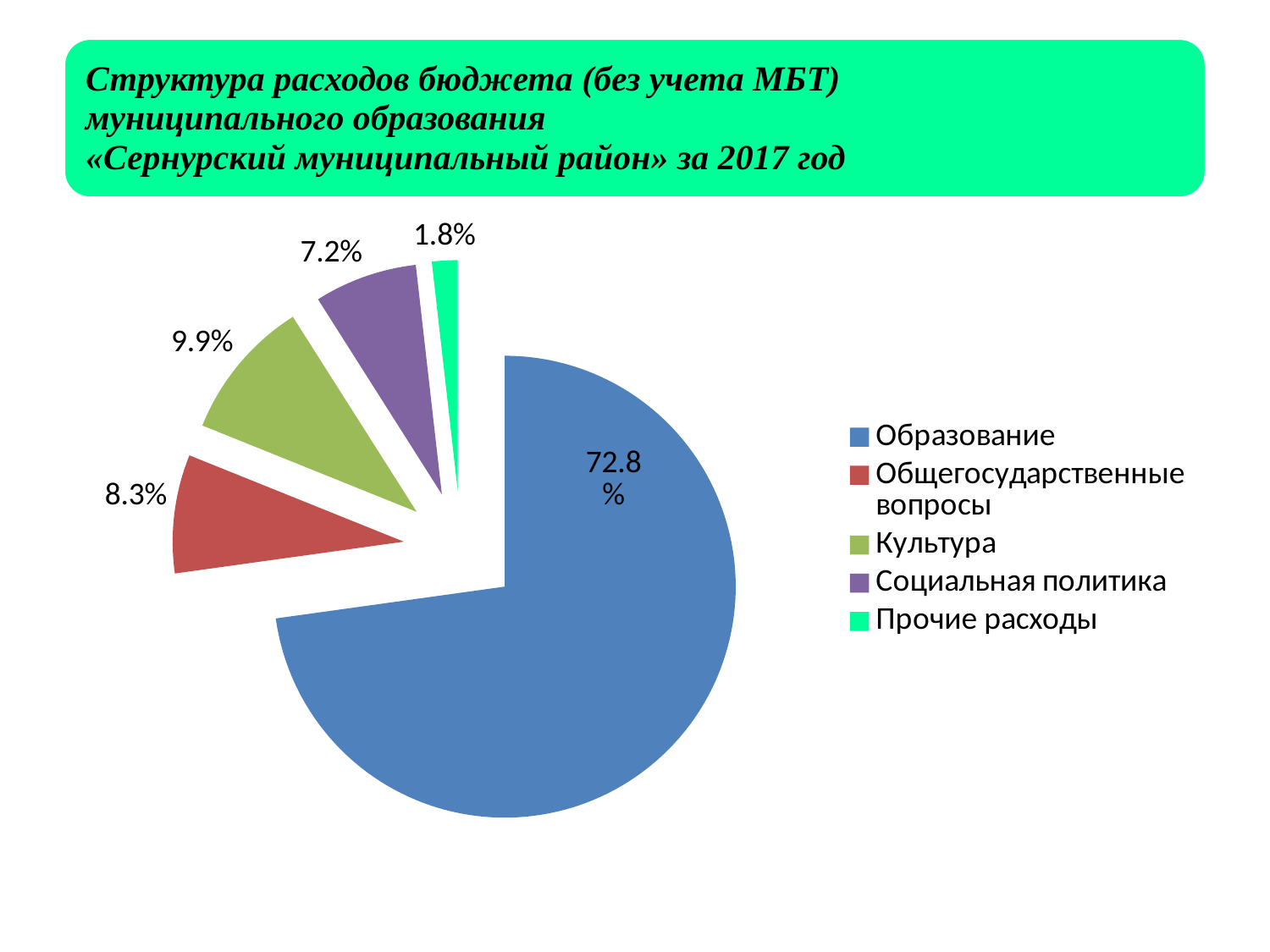
Which category is shown in blue in the legend? Образование What kind of chart is shown on the slide? Pie chart What is the value shown for Культура? 9.9% What is the value shown for Прочие расходы? 1.8% How many categories are shown in the pie chart? 5 What is the value shown for Социальная политика? 7.2% What is the value shown for Общегосударственные вопросы? 8.3% Which category has the smallest slice of the pie? Прочие расходы What share of the pie does Образование account for? 72.8% What is the difference between the shares of Культура and Общегосударственные вопросы? 1.6% Which category has the largest slice of the pie? Образование Which is larger, the share for Социальная политика or the share for Культура? Культура